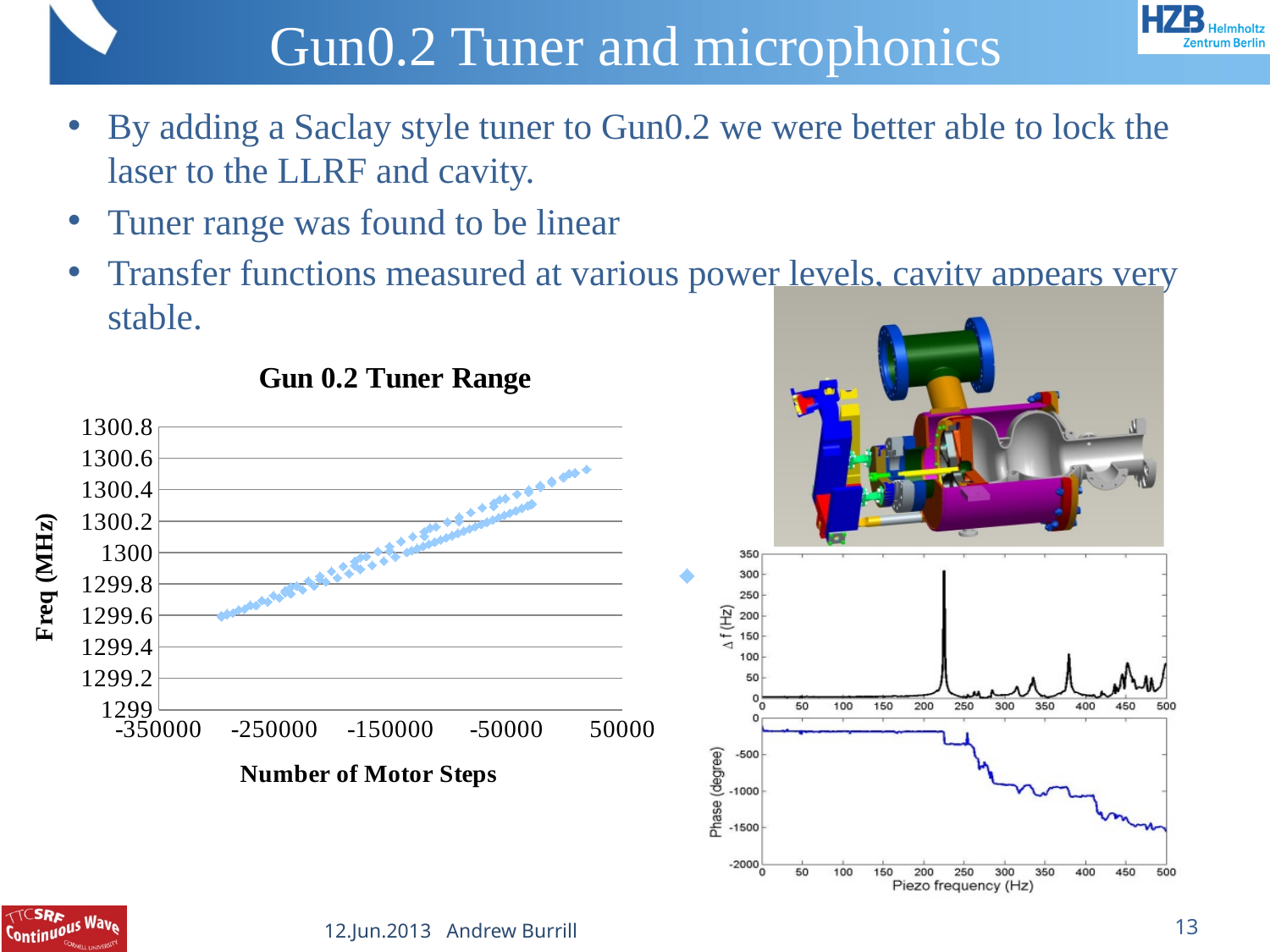
In the 'Gun 0.2 Tuner Range' chart, does the frequency rise or fall as the number of motor steps increases? rise In the lower transfer function plot on the right, is the phase at 100 Hz greater or less than -500 degrees? greater In the 'Gun 0.2 Tuner Range' chart, is the frequency at -50000 motor steps greater or less than 1300 MHz? greater In the lower transfer function plot on the right (Phase vs piezo frequency), does the phase rise or fall as piezo frequency increases? fall What is the x-axis label of the two transfer function plots on the right? Piezo frequency (Hz) In the upper transfer function plot on the right (Δf vs piezo frequency), is the tallest peak located at a piezo frequency greater or less than 200 Hz? greater What is the x-axis label of the 'Gun 0.2 Tuner Range' chart? Number of Motor Steps What is the y-axis label of the 'Gun 0.2 Tuner Range' chart? Freq (MHz) What kind of chart is the 'Gun 0.2 Tuner Range' chart? scatter chart